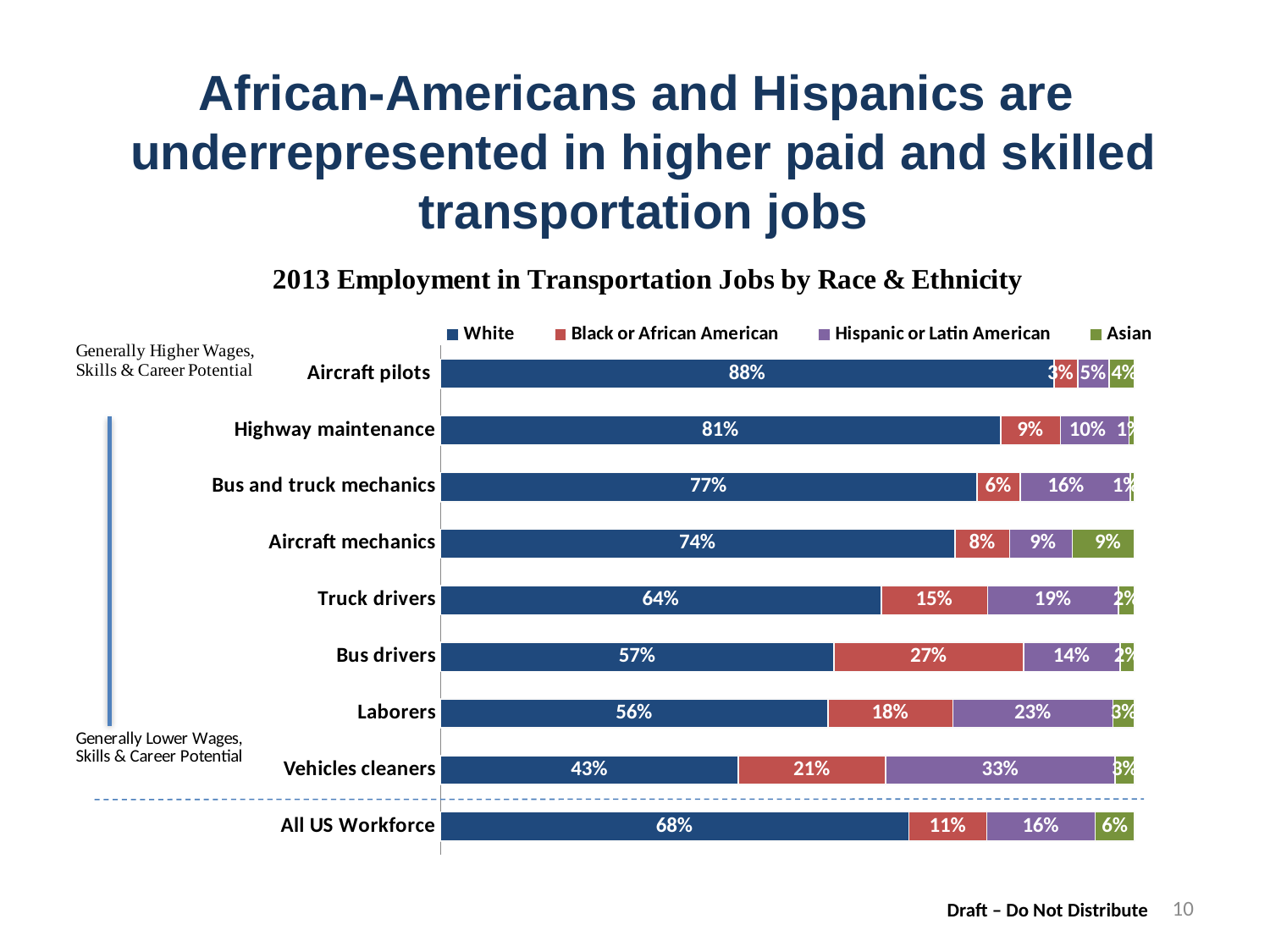
What kind of chart is shown on the slide? Stacked bar chart What is the title of the chart? 2013 Employment in Transportation Jobs by Race & Ethnicity What is the difference between the White share for Aircraft pilots and the White share for Vehicles cleaners? 45 percentage points What is the Black or African American share for Bus drivers? 27% How many job categories (including All US Workforce) are plotted on the chart? 9 Which category has the highest White share? Aircraft pilots What is the Hispanic or Latin American share for Vehicles cleaners? 33% What is the Asian share for All US Workforce? 6% What is the White share for Aircraft pilots? 88% Which category has the lowest White share? Vehicles cleaners Which has a larger Black or African American share, Bus drivers or Truck drivers? Bus drivers How many series does the legend list? 4